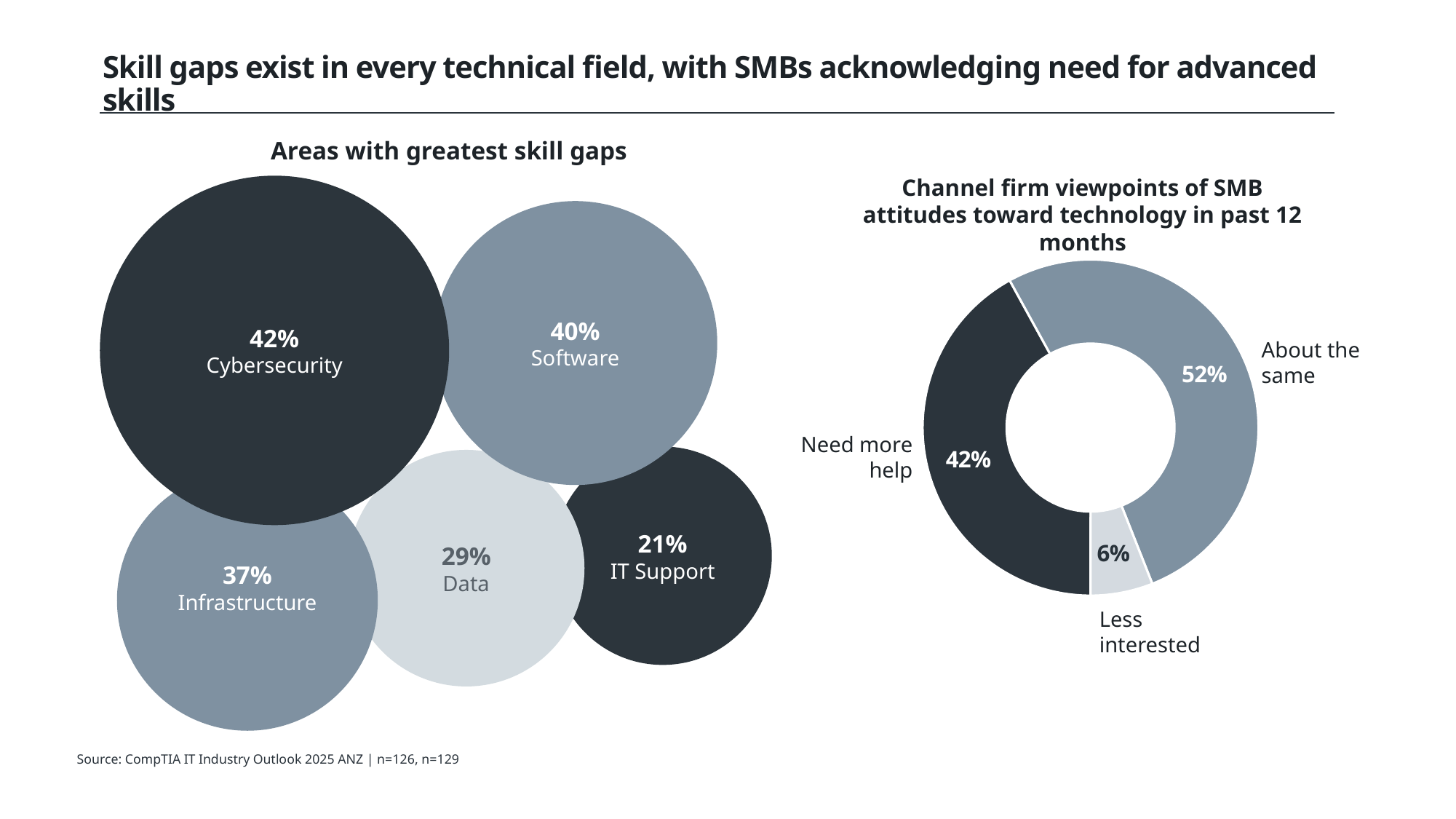
What kind of chart is the 'Channel firm viewpoints of SMB attitudes toward technology in past 12 months' chart? Doughnut chart In the 'Channel firm viewpoints of SMB attitudes toward technology in past 12 months' chart, what is the difference between 'About the same' and 'Need more help'? 10 percentage points In the 'Areas with greatest skill gaps' chart, which area has the lowest percentage? IT Support In the 'Areas with greatest skill gaps' chart, what percentage is shown for Data? 29% In the 'Areas with greatest skill gaps' chart, how many areas are shown? 5 In the 'Channel firm viewpoints of SMB attitudes toward technology in past 12 months' chart, what percentage is shown for 'Less interested'? 6% In the 'Channel firm viewpoints of SMB attitudes toward technology in past 12 months' chart, which category has the largest share? About the same In the 'Areas with greatest skill gaps' chart, which is larger: Infrastructure or IT Support? Infrastructure In the 'Areas with greatest skill gaps' chart, what is the difference between the Software and Infrastructure percentages? 3 percentage points In the 'Areas with greatest skill gaps' chart, what percentage is shown for Cybersecurity? 42% In the 'Areas with greatest skill gaps' chart, which area has the highest percentage? Cybersecurity In the 'Channel firm viewpoints of SMB attitudes toward technology in past 12 months' chart, what percentage is shown for 'Need more help'? 42%